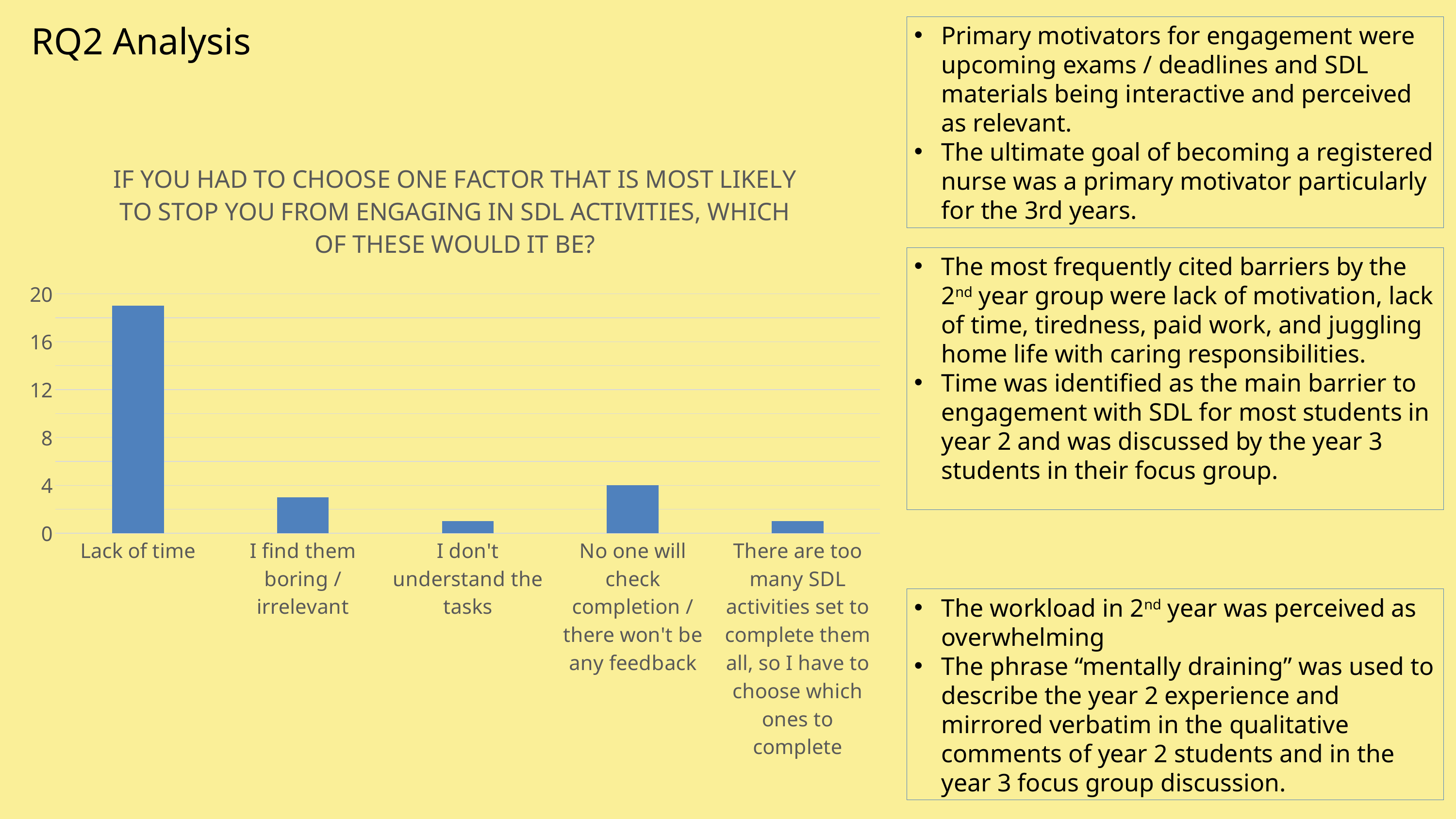
Which is larger: the value for "I find them boring / irrelevant" or the value for "I don't understand the tasks"? I find them boring / irrelevant Is the value for "Lack of time" greater or less than 12? greater Is the value for "There are too many SDL activities set to complete them all, so I have to choose which ones to complete" greater or less than 4? less Which is larger: the value for "No one will check completion / there won't be any feedback" or the value for "I find them boring / irrelevant"? No one will check completion / there won't be any feedback Is the value for "Lack of time" greater or less than 16? greater Which category has the highest bar in the chart? Lack of time How many categories are shown on the x axis of the chart? 5 What kind of chart is shown on the slide? bar chart Which is larger: the value for "Lack of time" or the value for "No one will check completion / there won't be any feedback"? Lack of time What is the title of the chart? IF YOU HAD TO CHOOSE ONE FACTOR THAT IS MOST LIKELY TO STOP YOU FROM ENGAGING IN SDL ACTIVITIES, WHICH OF THESE WOULD IT BE?